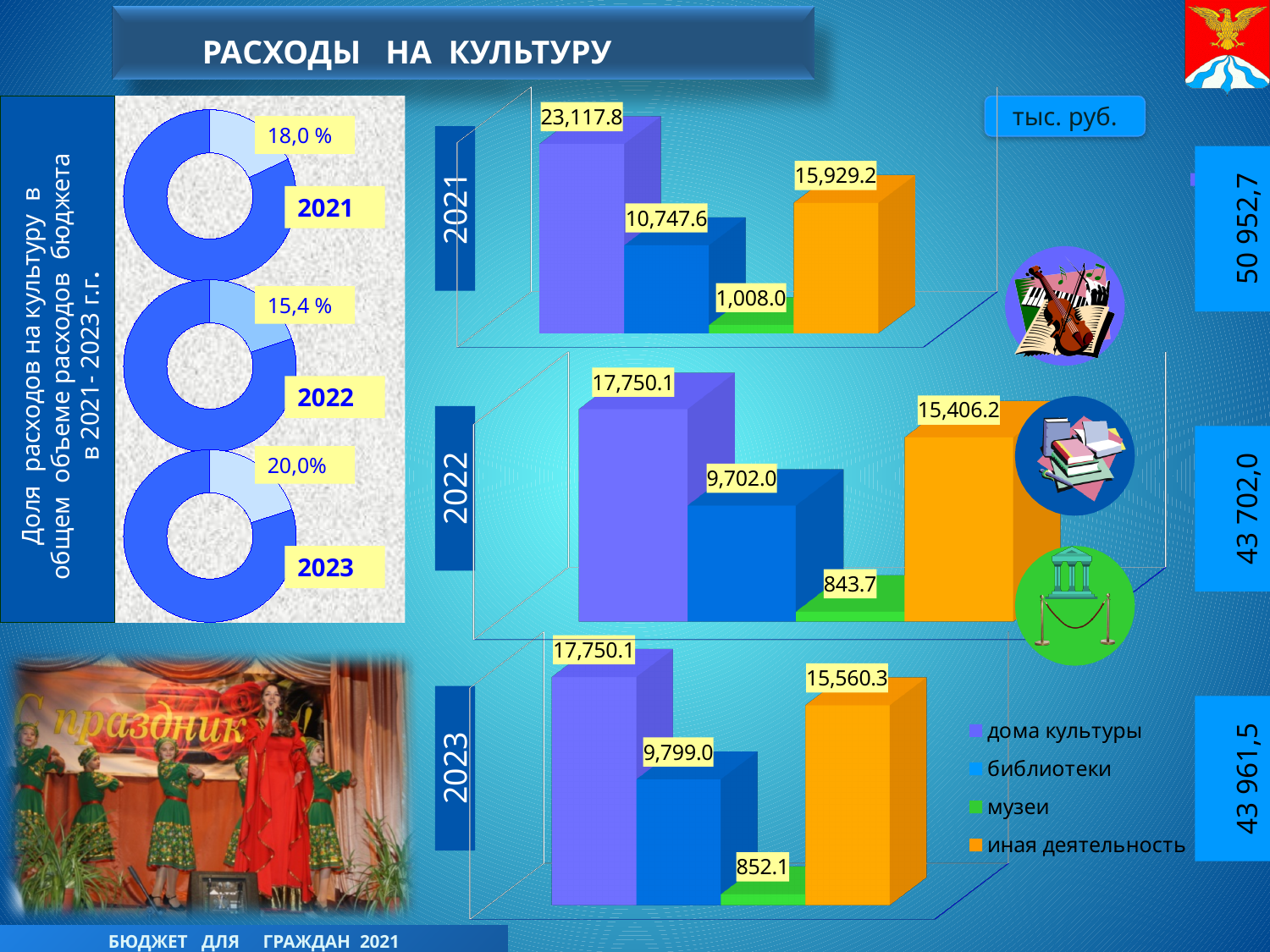
In the 2021 bar chart, which is larger: библиотеки or иная деятельность? иная деятельность In the 2022 bar chart, what is the value for библиотеки? 9,702.0 In the donut chart for 2023, what share of total budget expenditure goes to culture? 20,0% In the 2023 bar chart, what is the value for музеи? 852.1 In the donut chart for 2022, what share of total budget expenditure goes to culture? 15,4 % In the 2023 bar chart, which category has the highest value? дома культуры What type of chart is used to show the 2021, 2022 and 2023 expenditure breakdowns? bar chart What colour represents иная деятельность in the bar charts? orange In the 2021 bar chart, which category has the lowest value? музеи How many categories does the legend of the bar charts list? 4 In the 2021 bar chart, what is the value for дома культуры? 23,117.8 In the 2022 bar chart, what is the difference between дома культуры and иная деятельность? 2,343.9